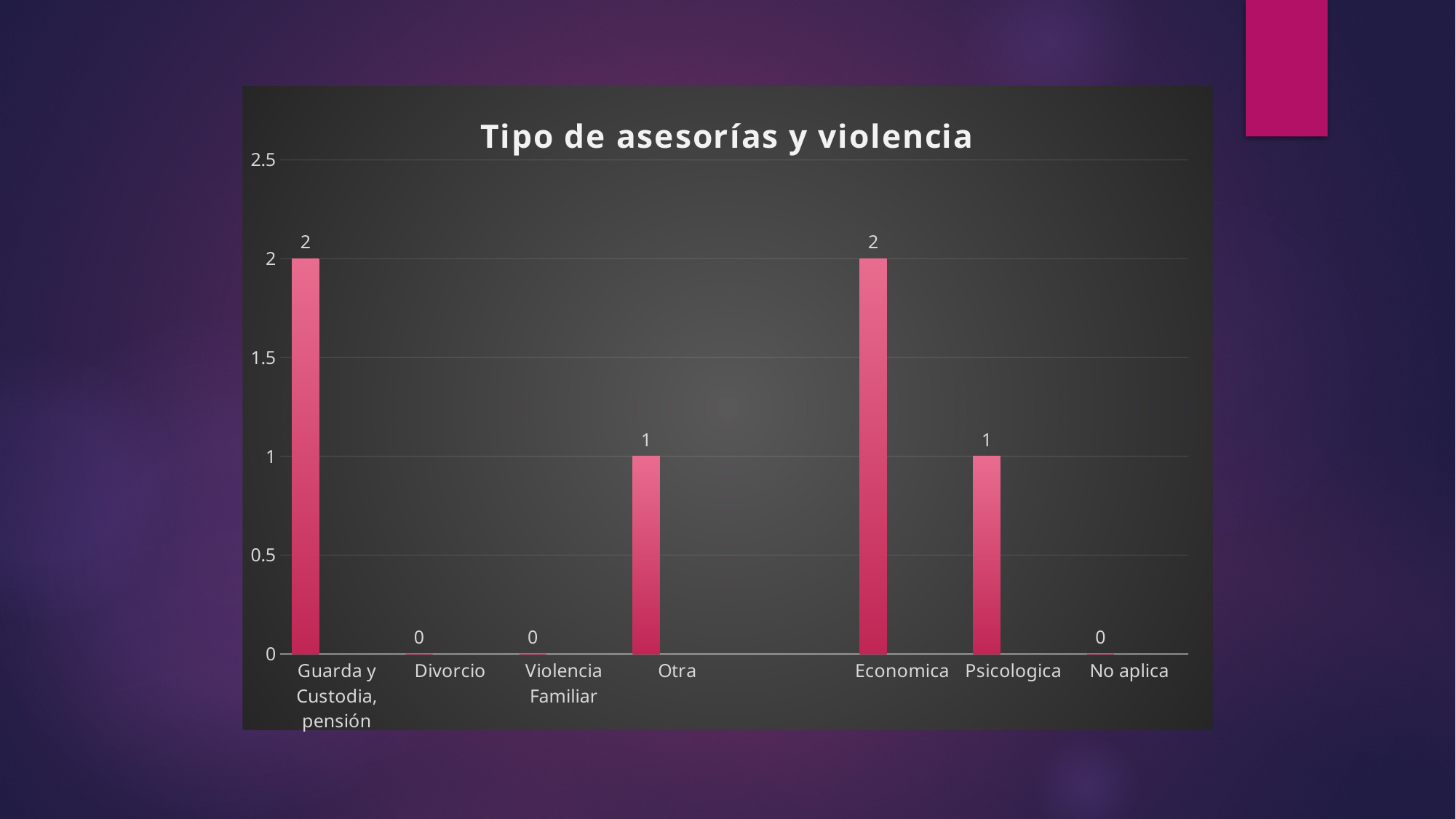
What is the value for Otra? 1 Which is larger, the value for Psicologica or the value for Violencia Familiar? Psicologica What is the difference between the values for Economica and Psicologica? 1 What is the value for Economica? 2 What is the value for Psicologica? 1 Which is larger, the value for Otra or the value for Guarda y Custodia, pensión? Guarda y Custodia, pensión What is the value for Guarda y Custodia, pensión? 2 What kind of chart is shown on the slide? Bar chart What is the value for No aplica? 0 What is the title of the chart? Tipo de asesorías y violencia What is the value for Divorcio? 0 Which two categories share the highest value in the chart? Guarda y Custodia, pensión and Economica